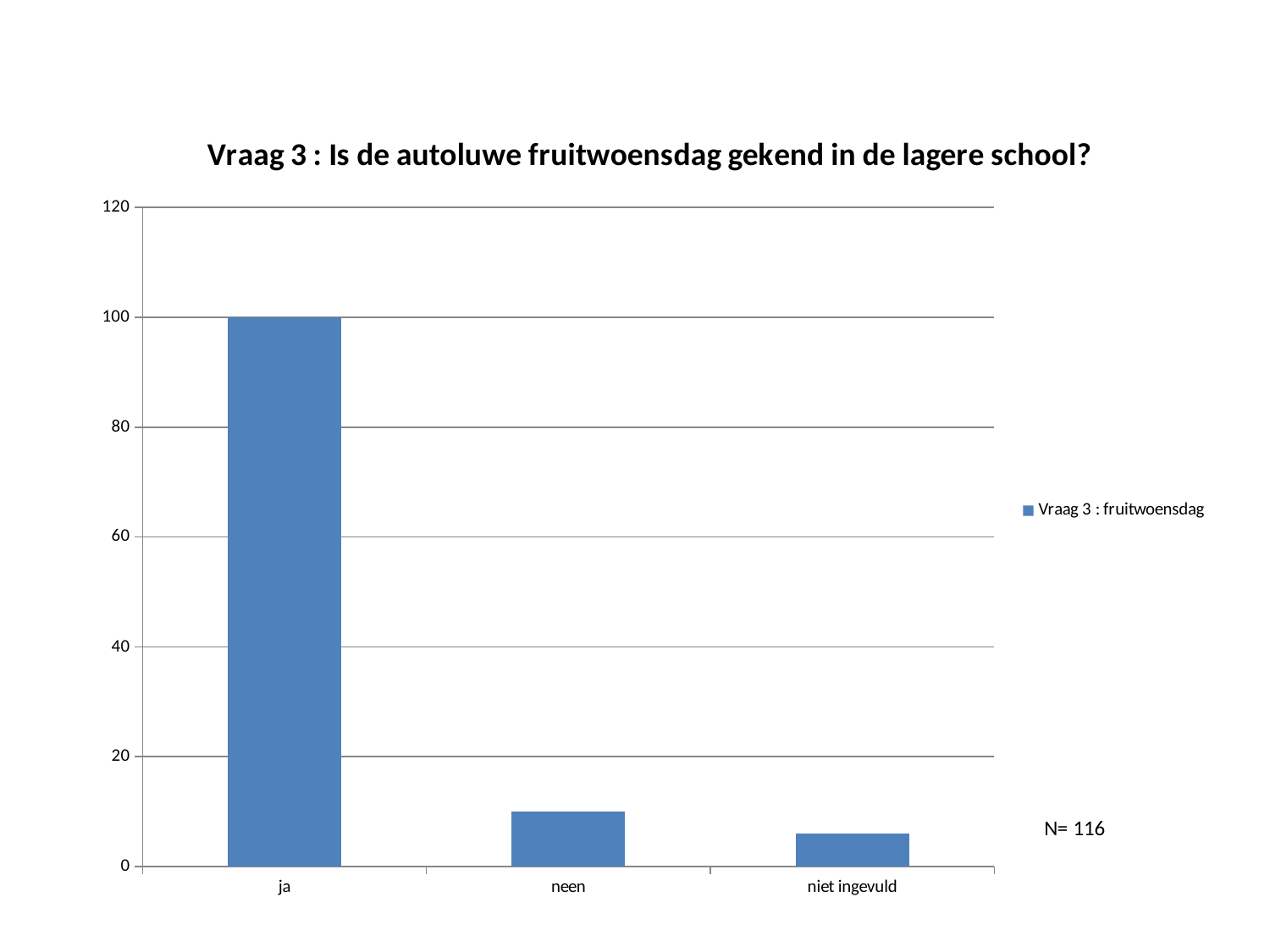
Which category has the highest value? ja Which category has the lowest value? niet ingevuld Which is larger, the value for 'neen' or the value for 'niet ingevuld'? neen How many series does the legend list? 1 How many categories are shown on the x axis of the chart? 3 What is the series name shown in the legend? Vraag 3 : fruitwoensdag What is the value for 'ja'? 100 What is the title of the chart? Vraag 3 : Is de autoluwe fruitwoensdag gekend in de lagere school? Is the value for 'ja' greater or less than 80? greater Is the value for 'niet ingevuld' greater or less than 20? less What kind of chart is shown on the slide? bar chart Is the value for 'neen' greater or less than 20? less